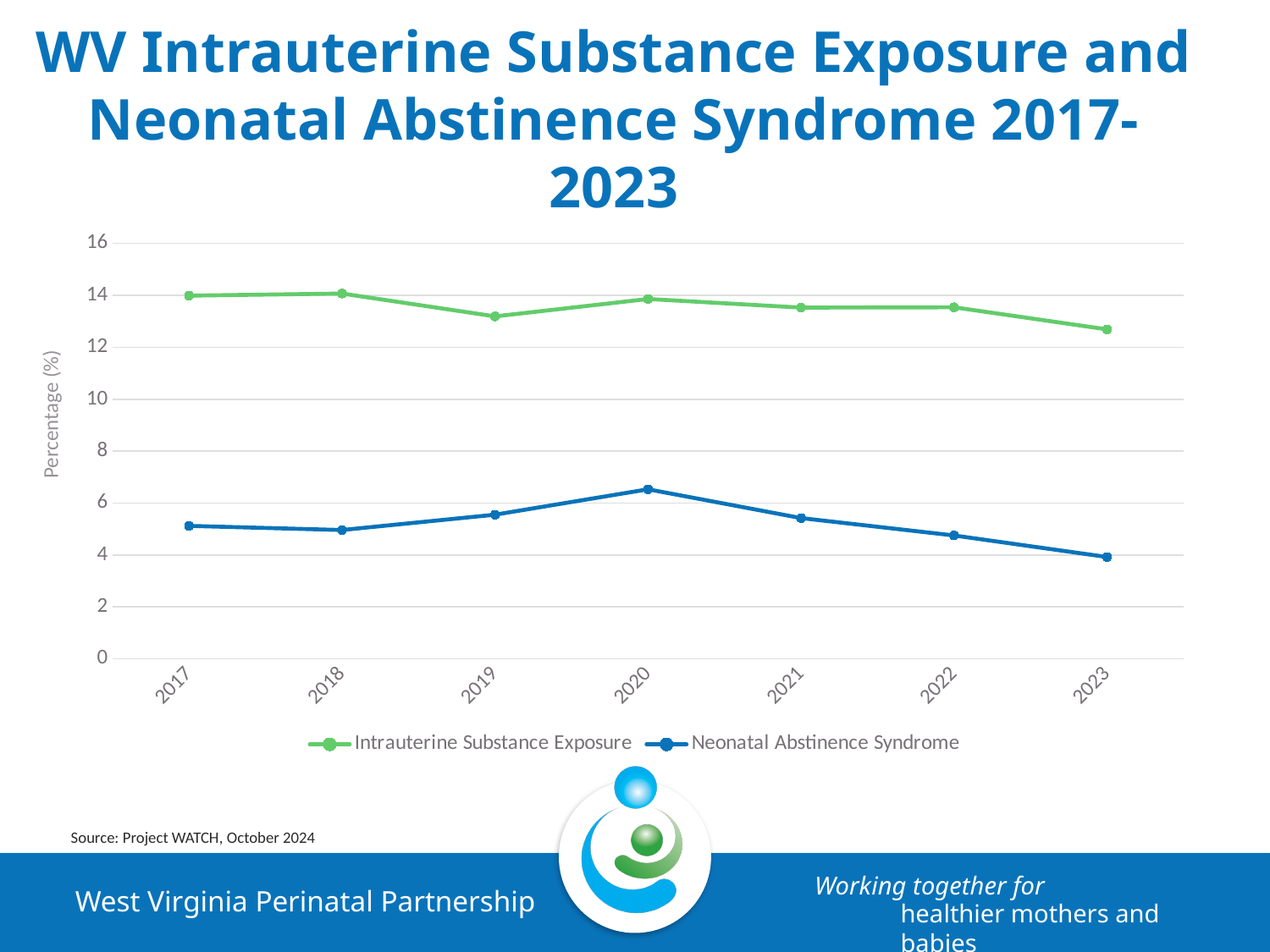
Does the Neonatal Abstinence Syndrome line rise or fall from 2020 to 2023? fall What kind of chart is shown on the slide? line chart How many years are plotted along the x axis? 7 In which year is the Neonatal Abstinence Syndrome value highest? 2020 Which is larger in 2017: Intrauterine Substance Exposure or Neonatal Abstinence Syndrome? Intrauterine Substance Exposure Is the Intrauterine Substance Exposure value for 2023 greater or less than 12? greater Is the Neonatal Abstinence Syndrome value for 2020 greater or less than 6? greater How many series does the legend list? 2 What is the label on the y axis? Percentage (%) In which year is the Neonatal Abstinence Syndrome value lowest? 2023 In which year is the Intrauterine Substance Exposure value lowest? 2023